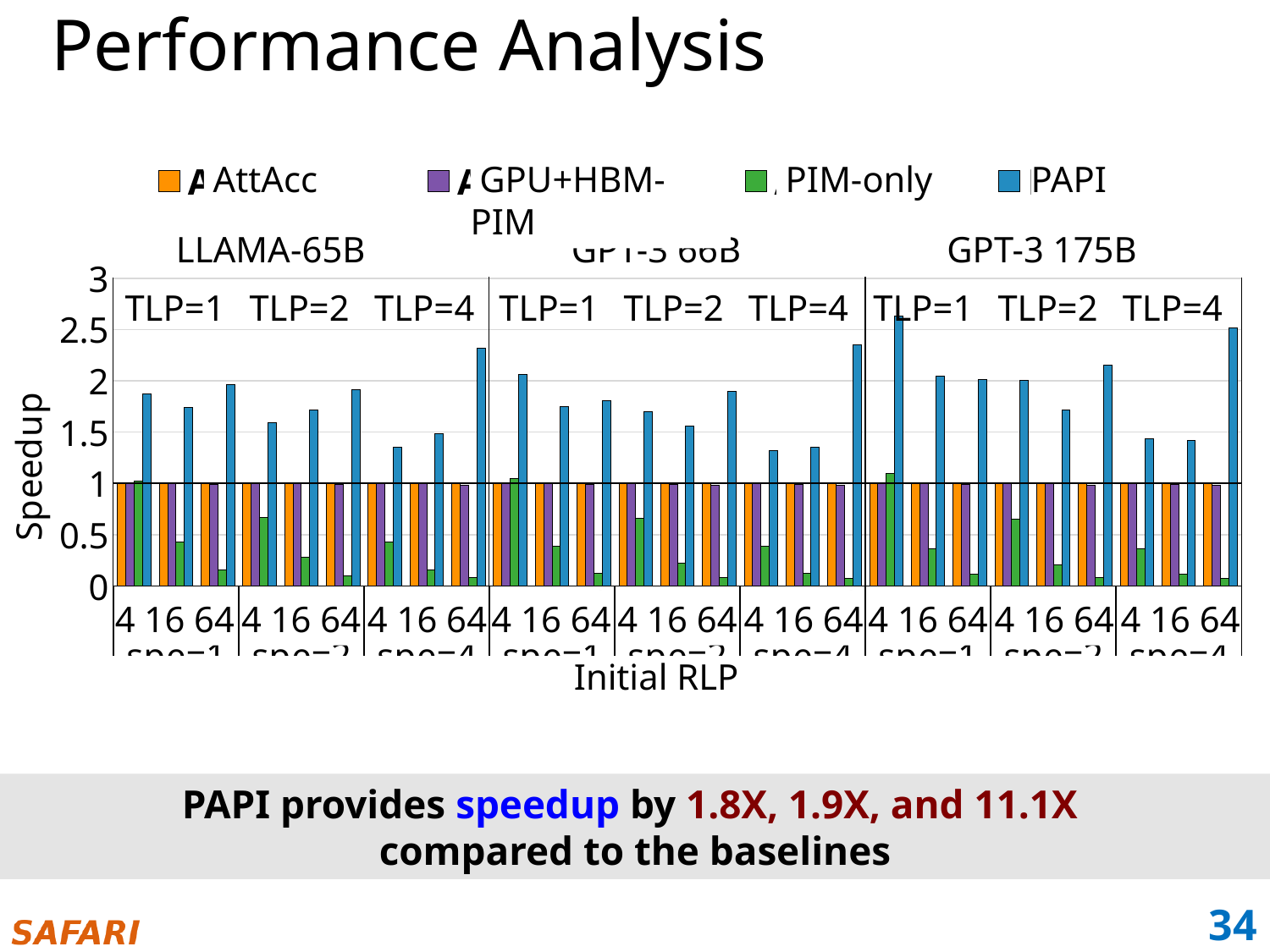
What is the title of the y axis? Speedup Is the PAPI value for LLAMA-65B, TLP=1, Initial RLP=4 greater or less than 1.5? greater What kind of chart is shown on the slide? bar chart How many model groups (LLAMA-65B, GPT-3 66B, GPT-3 175B) are shown along the x axis? 3 Is the PAPI value for GPT-3 66B, TLP=4, Initial RLP=4 greater or less than 1.5? less For LLAMA-65B, TLP=4, which is larger: the PAPI value at Initial RLP=4 or at Initial RLP=64? Initial RLP=64 How many series does the legend list? 4 Is the PAPI value for LLAMA-65B, TLP=4, Initial RLP=64 greater or less than 2? greater Within the LLAMA-65B TLP=1 group, does the PIM-only value rise or fall as Initial RLP increases from 4 to 64? fall What are the four series named in the legend? AttAcc, GPU+HBM-PIM, PIM-only, PAPI Which series has the tallest bar anywhere in the chart? PAPI